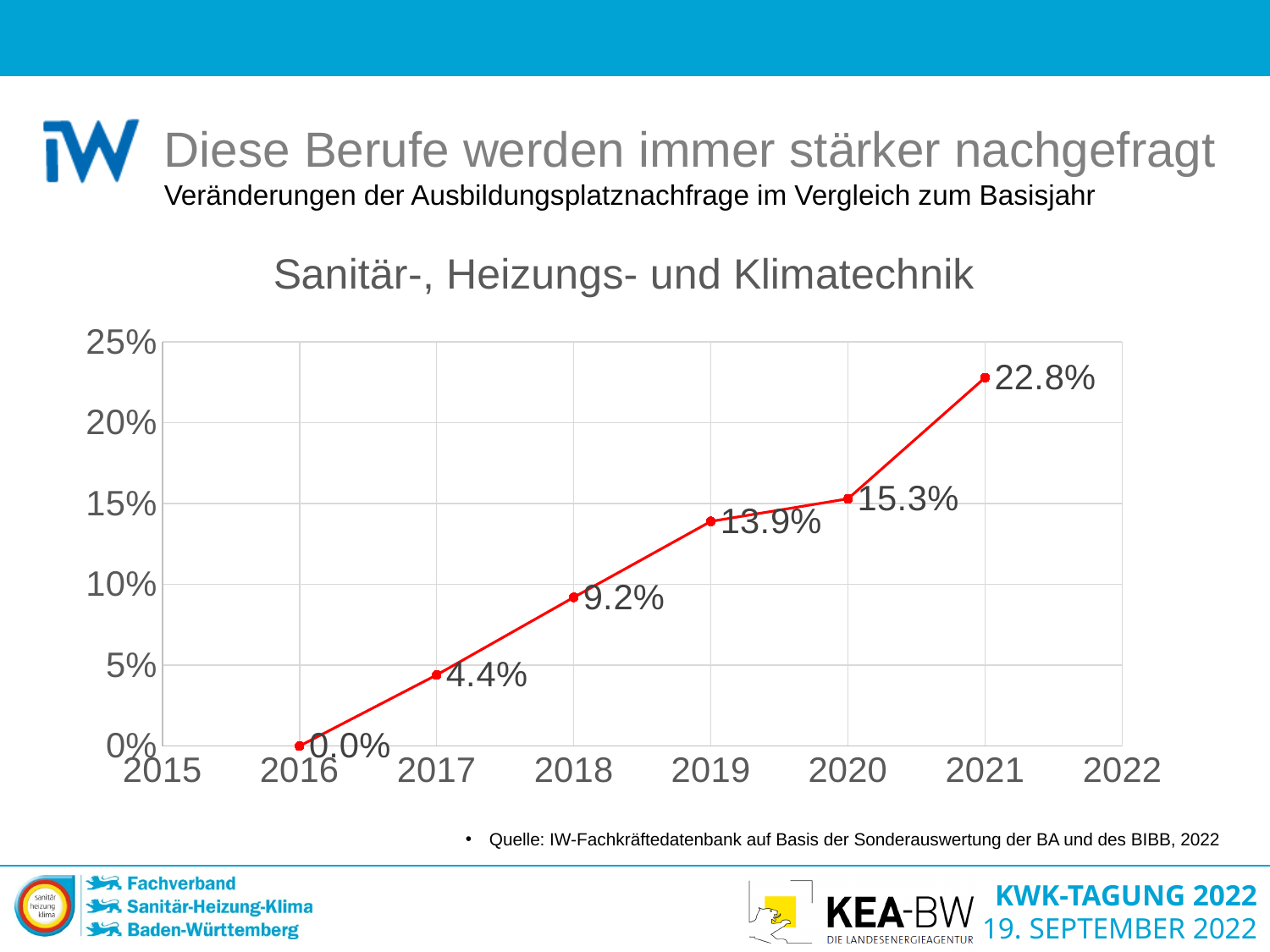
What is the value for 2021? 22.8% Which is larger, the value for 2019 or the value for 2018? 2019 Which year has the lowest value? 2016 What is the difference between the values for 2019 and 2017? 9.5% How many data points are plotted on the line? 6 What is the value for 2016? 0.0% Which year has the highest value? 2021 Do the values rise or fall from 2016 to 2021? rise What is the difference between the values for 2021 and 2020? 7.5% What is the value for 2020? 15.3% What is the value for 2018? 9.2% What kind of chart is shown? line chart